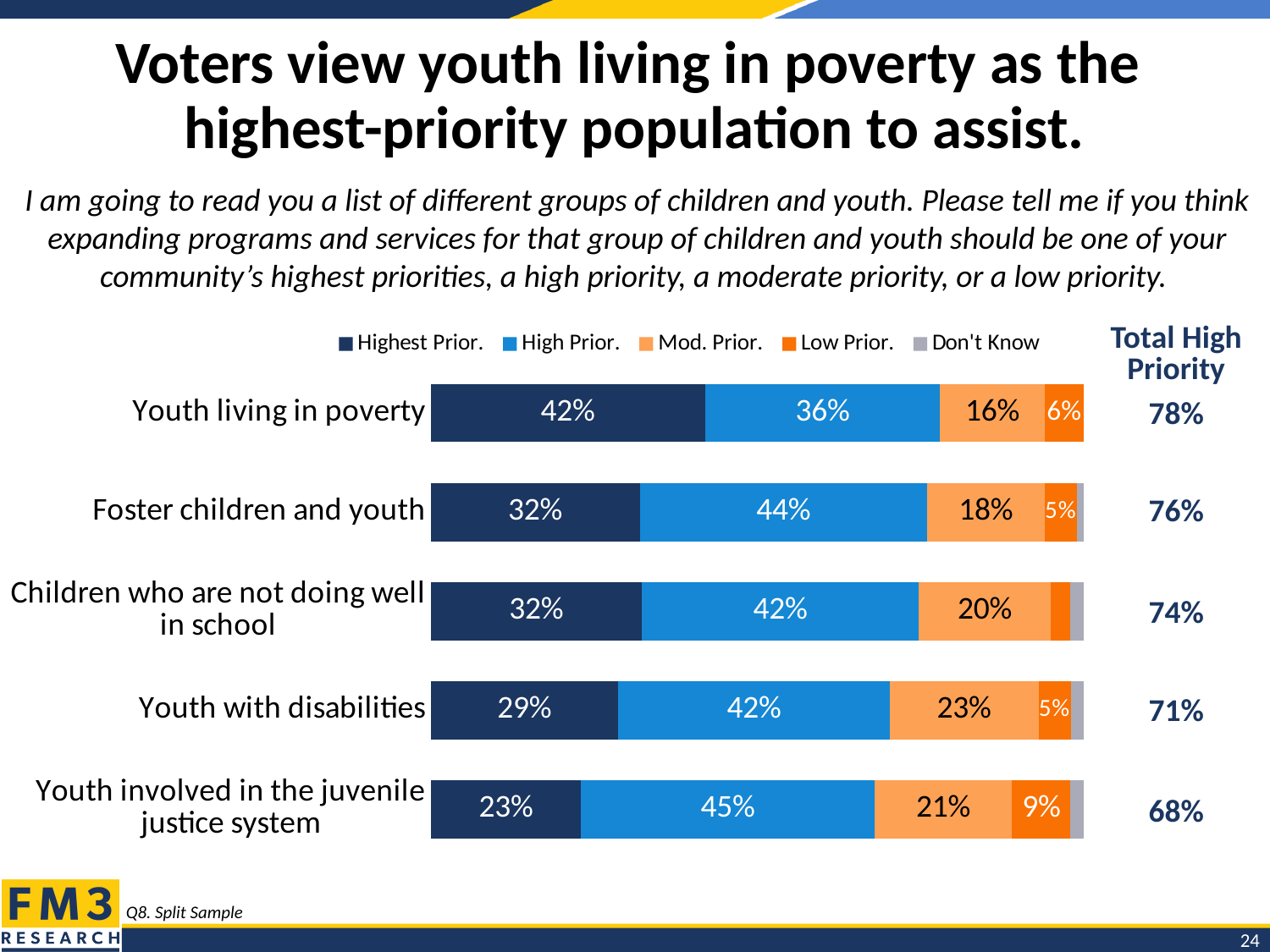
What is the difference between the "Highest Prior." values for "Youth living in poverty" and "Youth involved in the juvenile justice system"? 19 percentage points Which is larger: the "High Prior." value for "Foster children and youth" or for "Youth living in poverty"? Foster children and youth How many groups of children and youth are shown in the chart? 5 Which group has the lowest Total High Priority figure? Youth involved in the juvenile justice system Which group has the highest "Highest Prior." percentage? Youth living in poverty What kind of chart is shown on the slide? Stacked bar chart What is the "High Prior." value for "Youth involved in the juvenile justice system"? 45% How many series does the legend list? 5 What is the "Low Prior." value for "Youth involved in the juvenile justice system"? 9% What is the "Mod. Prior." value for "Youth with disabilities"? 23% What is the Total High Priority figure shown for "Foster children and youth"? 76% What percentage of voters rated "Youth living in poverty" as the highest priority? 42%